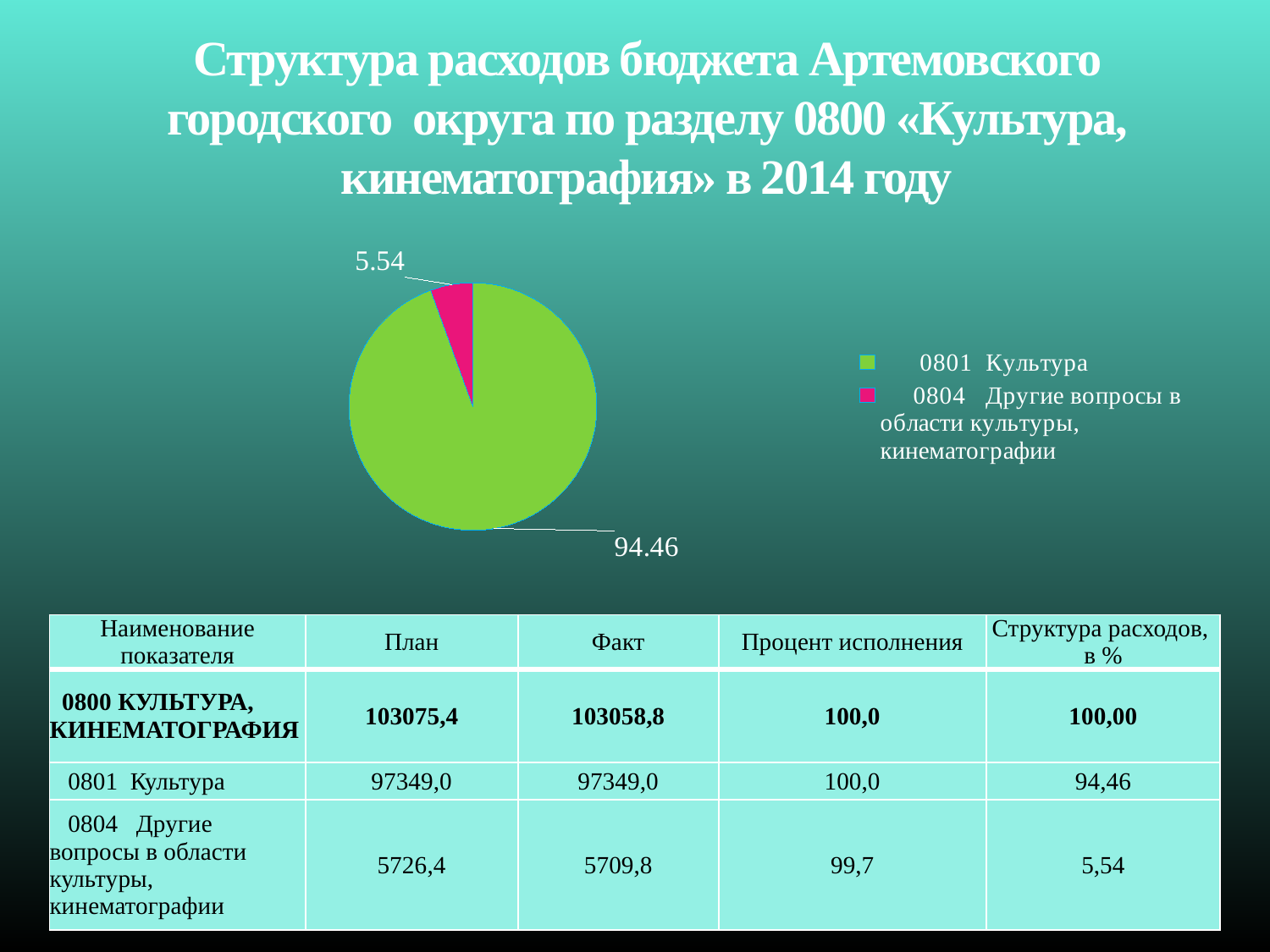
What colour is the slice for 0804 Другие вопросы в области культуры, кинематографии in the pie chart? pink What kind of chart is shown on the slide? pie chart How many entries does the pie chart's legend list? 2 How many slices does the pie chart have? 2 Which is larger in the pie chart: the slice for 0801 Культура or the slice for 0804 Другие вопросы в области культуры, кинематографии? 0801 Культура What is the difference between the two slice values shown in the pie chart (94.46 and 5.54)? 88.92 Which slice of the pie chart is the smallest? 0804 Другие вопросы в области культуры, кинематографии What colour is the slice for 0801 Культура in the pie chart? green What value is shown for the slice "0804 Другие вопросы в области культуры, кинематографии" in the pie chart? 5.54 Which slice of the pie chart is the largest? 0801 Культура What value is shown for the slice "0801 Культура" in the pie chart? 94.46